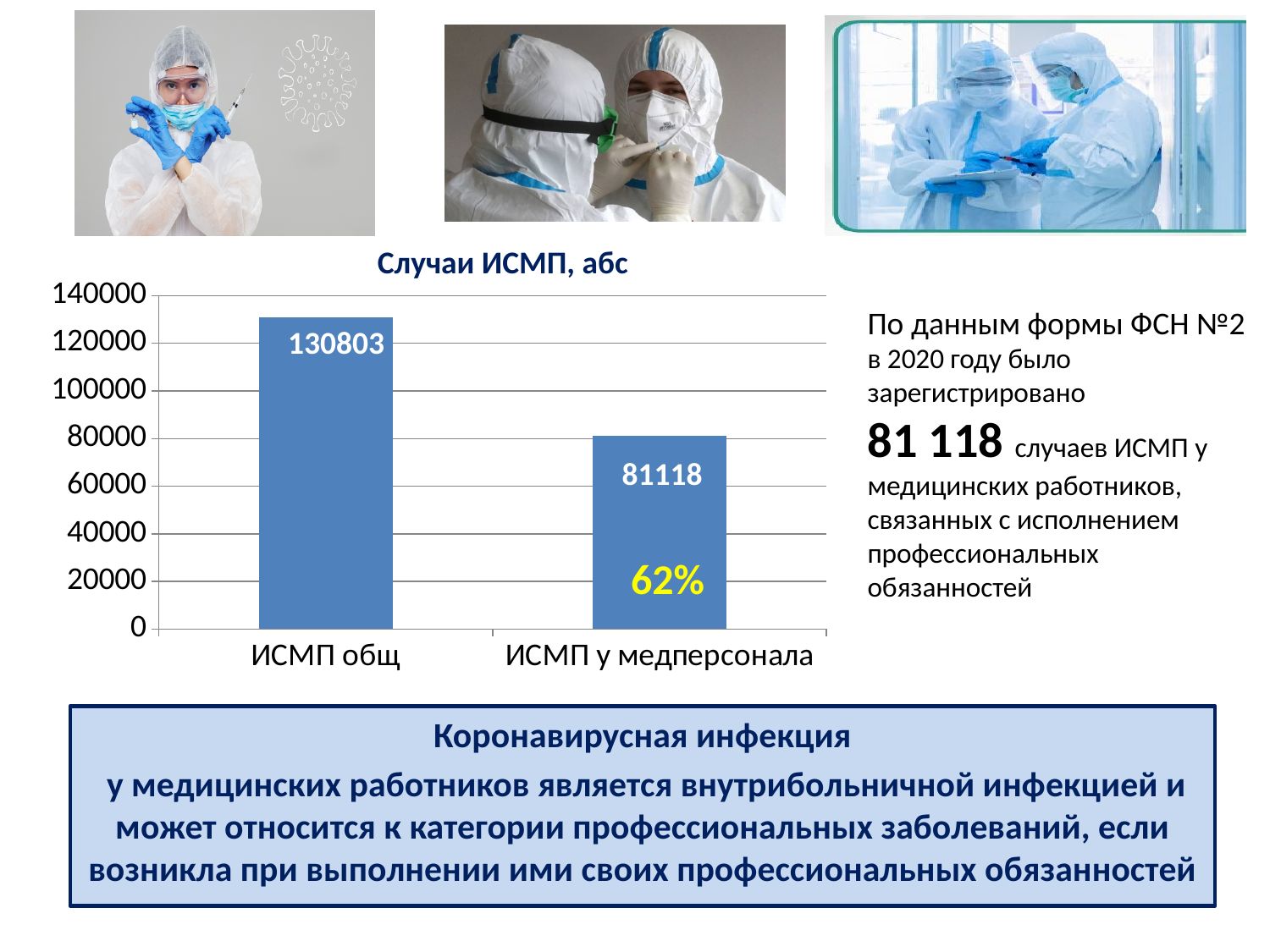
What percentage label is shown inside the bar for ИСМП у медперсонала? 62% Which category has the highest value? ИСМП общ Which category has the lowest value? ИСМП у медперсонала Is the value for ИСМП общ greater or less than 120000? greater What is the title of the chart? Случаи ИСМП, абс What is the value for ИСМП общ? 130803 Which is larger, the value for ИСМП общ or the value for ИСМП у медперсонала? ИСМП общ What is the difference between the values for ИСМП общ and ИСМП у медперсонала? 49685 Is the value for ИСМП у медперсонала greater or less than 100000? less How many categories are shown on the chart? 2 What kind of chart is shown on the slide? bar chart What is the value for ИСМП у медперсонала? 81118